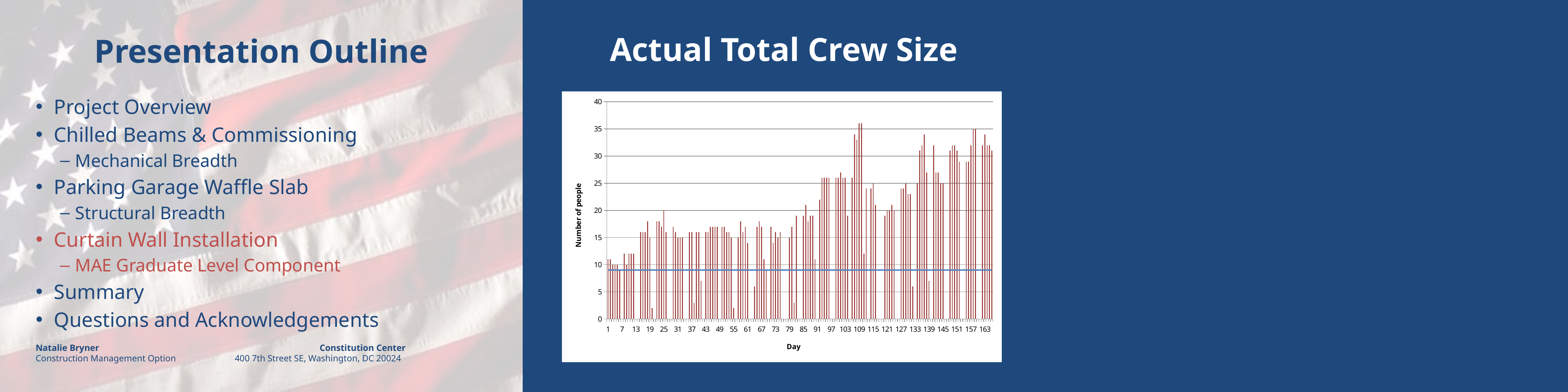
Do the crew size values generally rise or fall from day 1 to day 163? rise Is the value for day 1 greater or less than 15? less Is the value for day 13 greater or less than 20? less What is the last day label shown on the horizontal axis? 163 What kind of chart is shown on the slide? bar chart Is the tallest bar in the chart greater or less than 30? greater What is the highest value shown on the vertical axis? 40 What is the label on the vertical axis of the chart? Number of people